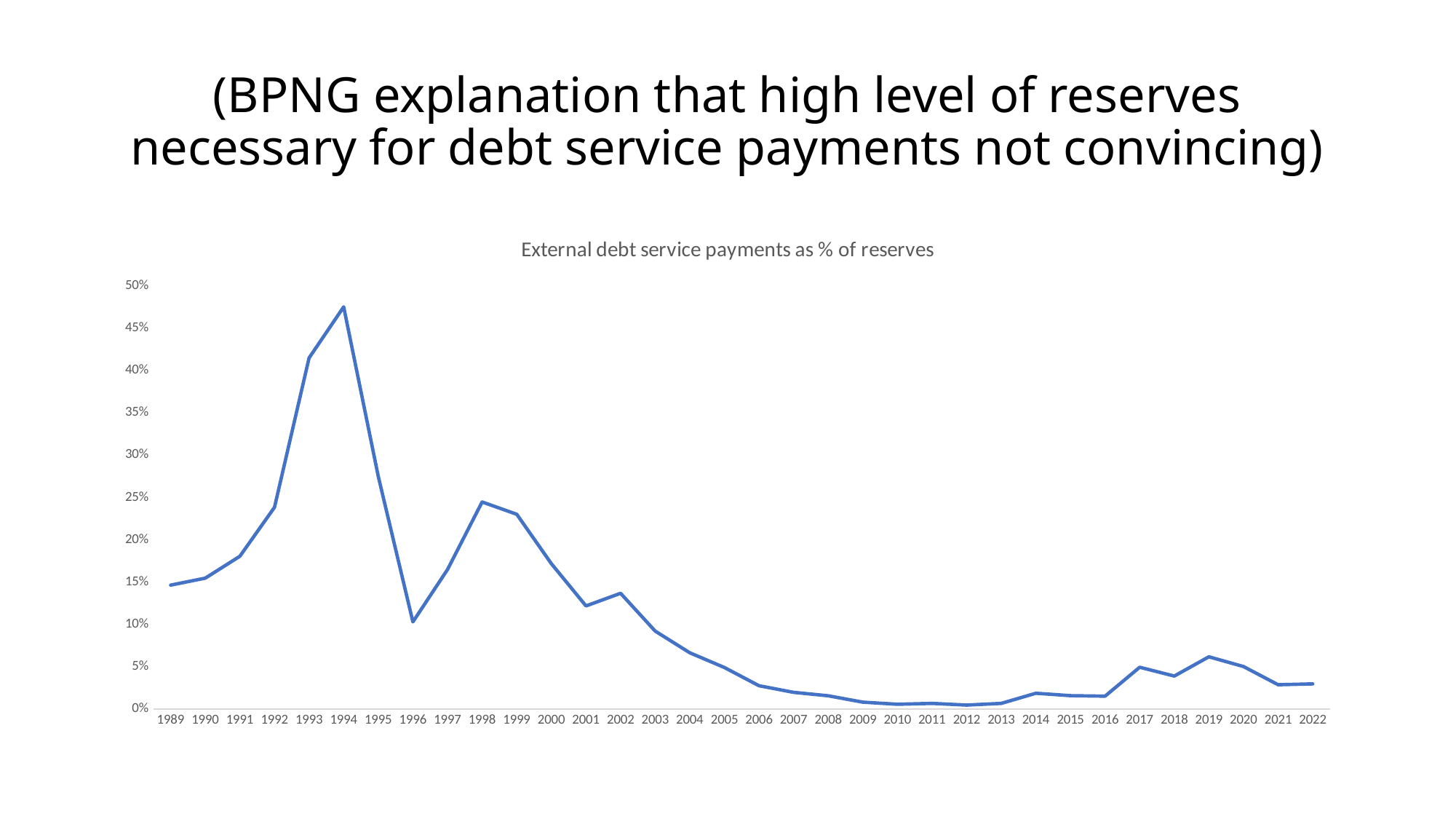
In which year is external debt service payments as % of reserves highest? 1994 Is the value for 1989 greater or less than 10%? greater Do the values rise or fall from 2002 to 2010? fall What is the title of the chart? External debt service payments as % of reserves Which year has the larger value, 1994 or 1998? 1994 Is the value for 2022 greater or less than 5%? less What kind of chart is shown on the slide? line chart How many years are plotted along the x axis? 34 Is the value for 1998 greater or less than 20%? greater Do the values rise or fall from 1989 to 1994? rise